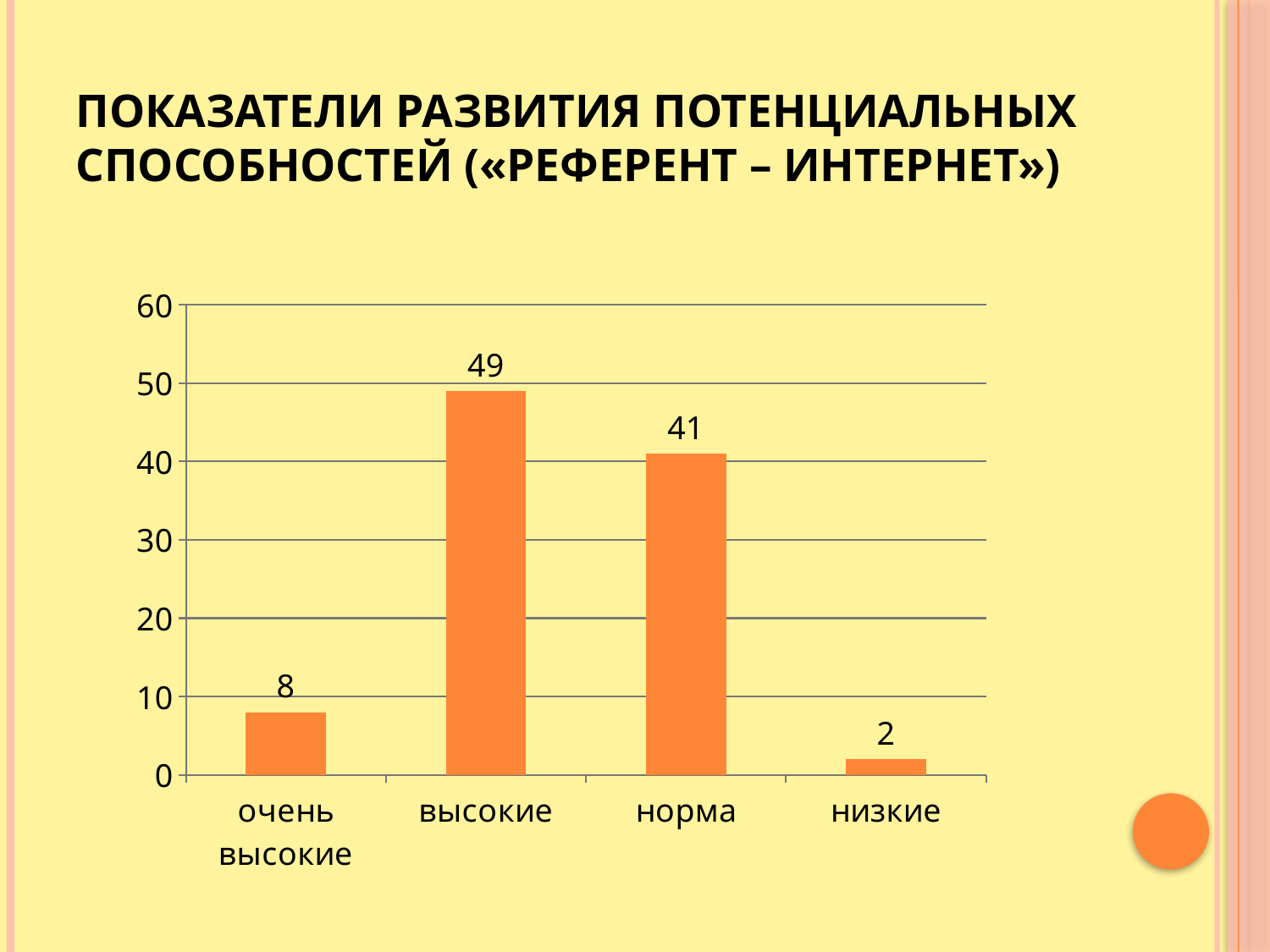
What is the value for the "норма" category? 41 Is the value for "норма" greater or less than 30? greater What kind of chart is shown on the slide? bar chart Which is larger, the value for "очень высокие" or the value for "низкие"? очень высокие How many categories are shown on the x axis? 4 What is the value for the "высокие" category? 49 Which category has the highest value? высокие What is the maximum value shown on the vertical axis? 60 What is the value for the "очень высокие" category? 8 Which category has the lowest value? низкие What is the value for the "низкие" category? 2 What is the difference between the values for "высокие" and "норма"? 8